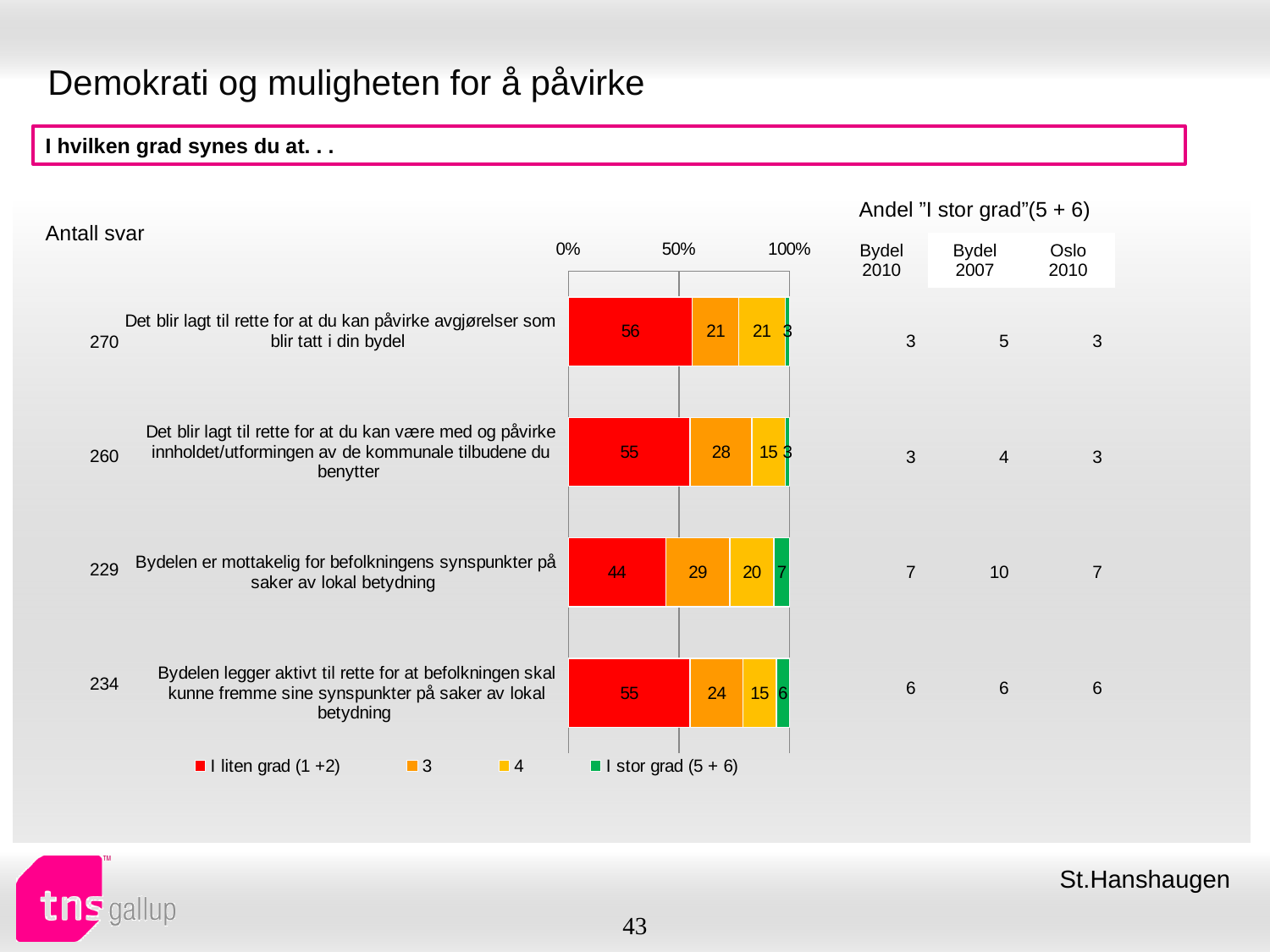
What is the total of the stacked bar for "Bydelen legger aktivt til rette for at befolkningen skal kunne fremme sine synspunkter på saker av lokal betydning"? 100 How many statements (categories) are plotted in the chart? 4 Which statement has the highest value for "I liten grad (1 +2)"? Det blir lagt til rette for at du kan påvirke avgjørelser som blir tatt i din bydel What is the difference between the series "3" value for "Bydelen er mottakelig for befolkningens synspunkter på saker av lokal betydning" and for "Det blir lagt til rette for at du kan påvirke avgjørelser som blir tatt i din bydel"? 8 Which has the larger value for series "4": "Det blir lagt til rette for at du kan påvirke avgjørelser som blir tatt i din bydel" or "Bydelen legger aktivt til rette for at befolkningen skal kunne fremme sine synspunkter på saker av lokal betydning"? Det blir lagt til rette for at du kan påvirke avgjørelser som blir tatt i din bydel What is the value of "I liten grad (1 +2)" for "Det blir lagt til rette for at du kan påvirke avgjørelser som blir tatt i din bydel"? 56 What kind of chart is shown on the slide? bar chart What is the value of "I stor grad (5 + 6)" for "Bydelen er mottakelig for befolkningens synspunkter på saker av lokal betydning"? 7 How many series does the legend list? 4 What is the value of series "3" for "Det blir lagt til rette for at du kan være med og påvirke innholdet/utformingen av de kommunale tilbudene du benytter"? 28 What colour represents "I stor grad (5 + 6)" in the chart? green Which statement has the lowest value for "I liten grad (1 +2)"? Bydelen er mottakelig for befolkningens synspunkter på saker av lokal betydning